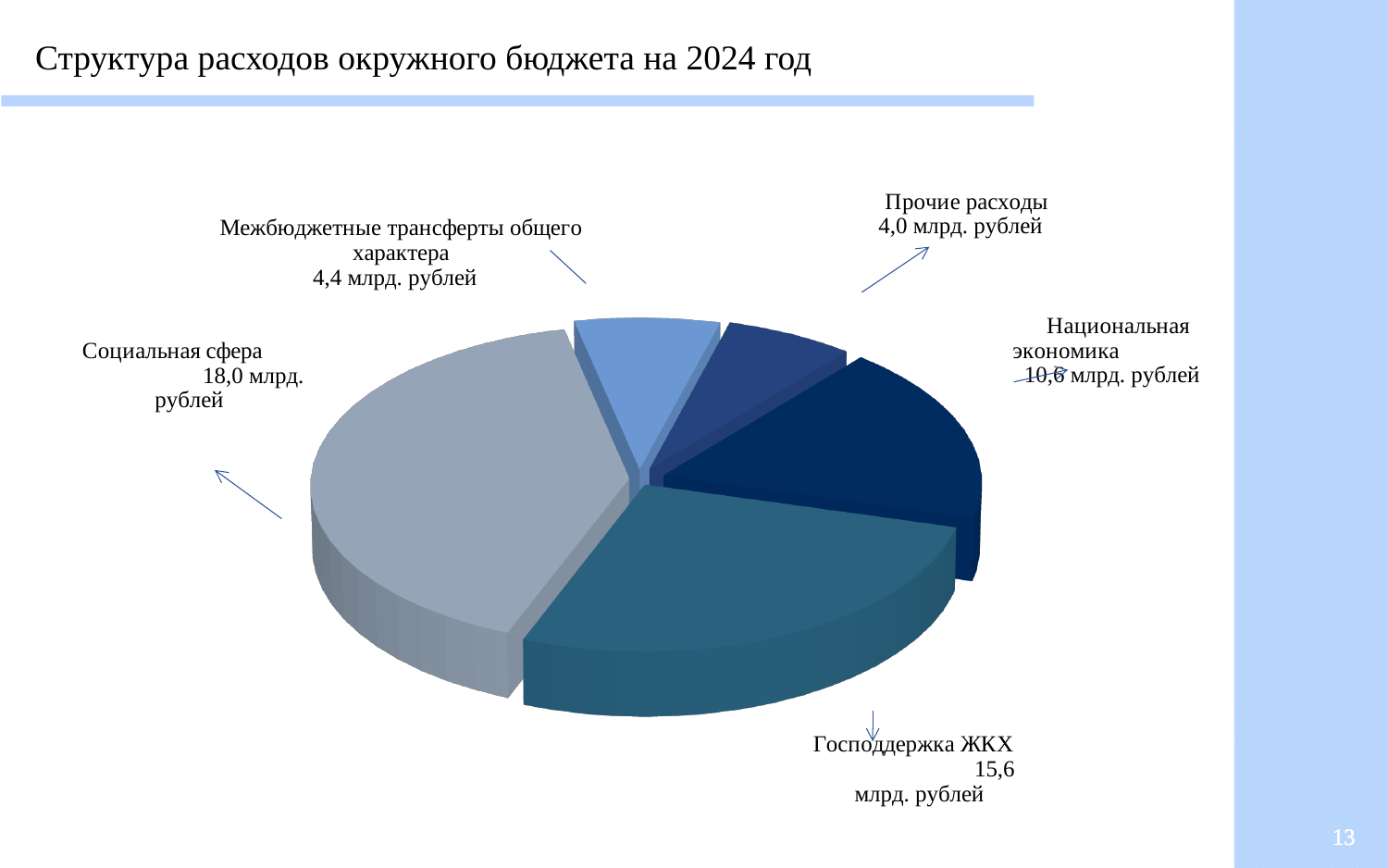
What is the value for Социальная сфера? 18,0 млрд. рублей What is the value for Национальная экономика? 10,6 млрд. рублей What is the difference between Социальная сфера and Господдержка ЖКХ? 2,4 млрд. рублей Which category has the smallest share of expenditures? Прочие расходы How many slices does the pie chart have? 5 What type of chart is shown on the slide? Pie chart What is the value for Межбюджетные трансферты общего характера? 4,4 млрд. рублей What is the value for Прочие расходы? 4,0 млрд. рублей Which category has the largest share of expenditures? Социальная сфера What is the value for Господдержка ЖКХ? 15,6 млрд. рублей What is the title of the chart on the slide? Структура расходов окружного бюджета на 2024 год Which is larger, Национальная экономика or Межбюджетные трансферты общего характера? Национальная экономика